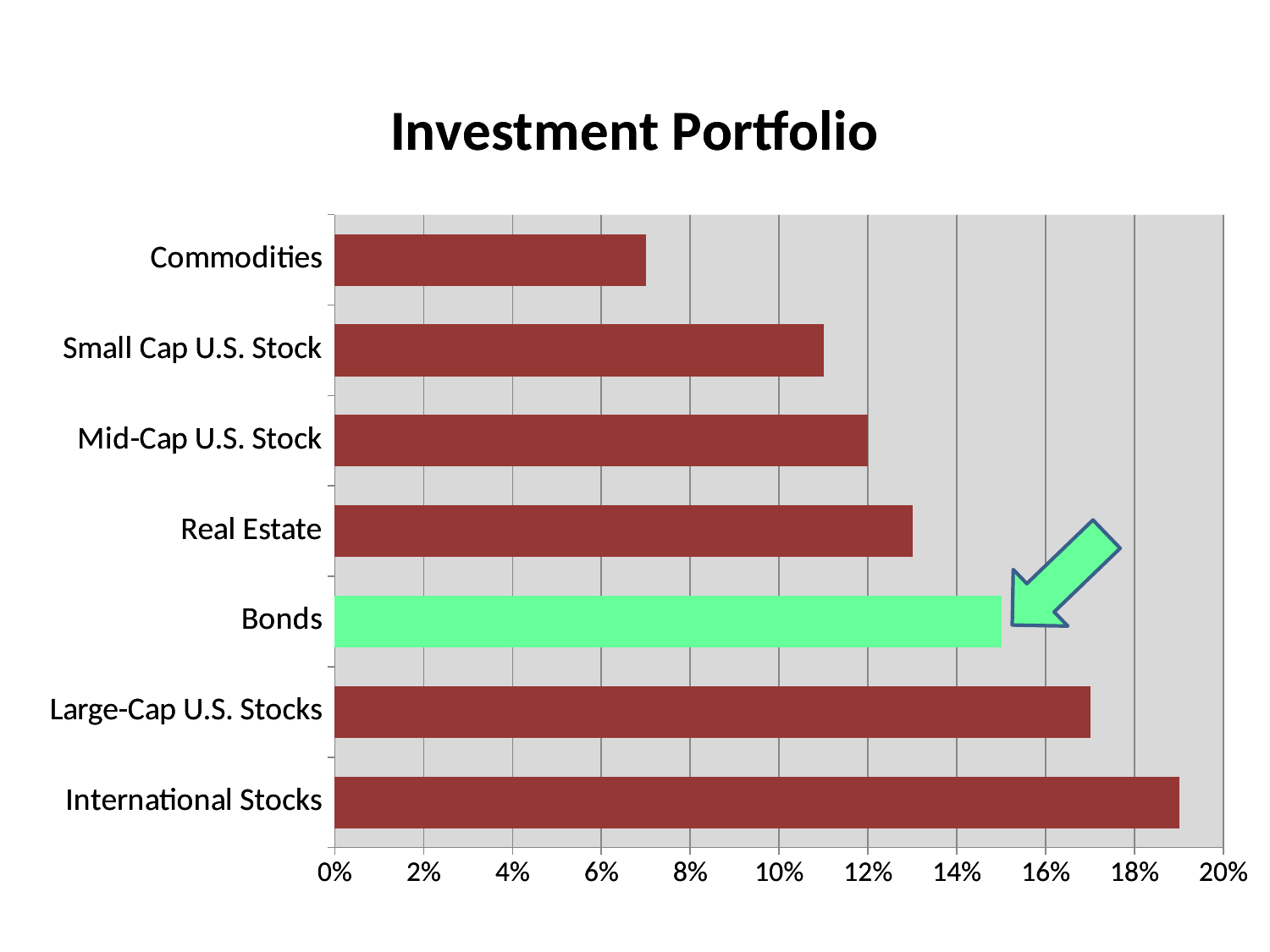
Is the value for Small Cap U.S. Stock greater or less than 10%? greater Which category has the highest value? International Stocks Which category has the lowest value? Commodities Is the value for International Stocks greater or less than 18%? greater Is the value for Commodities greater or less than 8%? less Which is larger, the value for Real Estate or the value for Large-Cap U.S. Stocks? Large-Cap U.S. Stocks How many categories are shown in the chart? 7 What type of chart is shown on the slide? bar chart What is the value for Mid-Cap U.S. Stock? 12% Which bar is highlighted in a different colour and pointed to by an arrow? Bonds What is the title of the chart? Investment Portfolio